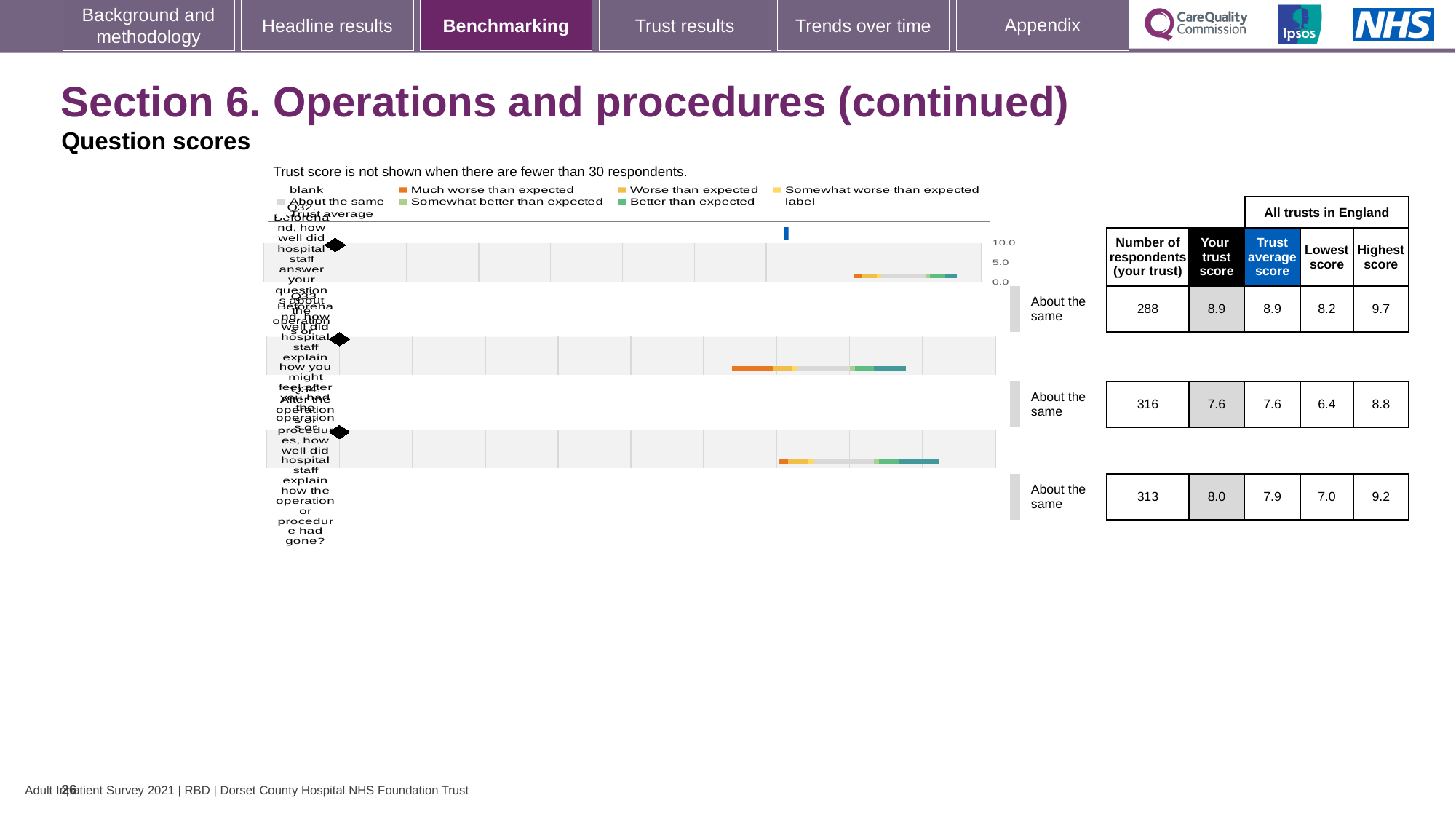
What is the highest value shown on the chart's score axis? 10.0 Which of the three question rows has the highest trust score? the first row (Q32) Which of the three question rows has the lowest trust score? the second row How many rating categories does the chart legend list, excluding 'blank', 'label' and 'Trust average'? 6 What is the trust score for the second question row in the chart? 7.6 What kind of chart is used to show the question scores on this slide? bar chart What is the difference between the trust score for the first row (8.9) and the second row (7.6)? 1.3 How many questions (rows) are plotted in the benchmarking chart? 3 What is the trust score for the first question row (Q32) in the chart? 8.9 What benchmark rating is shown for all three question rows in the chart? About the same Is the trust score for the second question row greater or less than 5.0 on the chart axis? greater What is the trust score for the third question row in the chart? 8.0